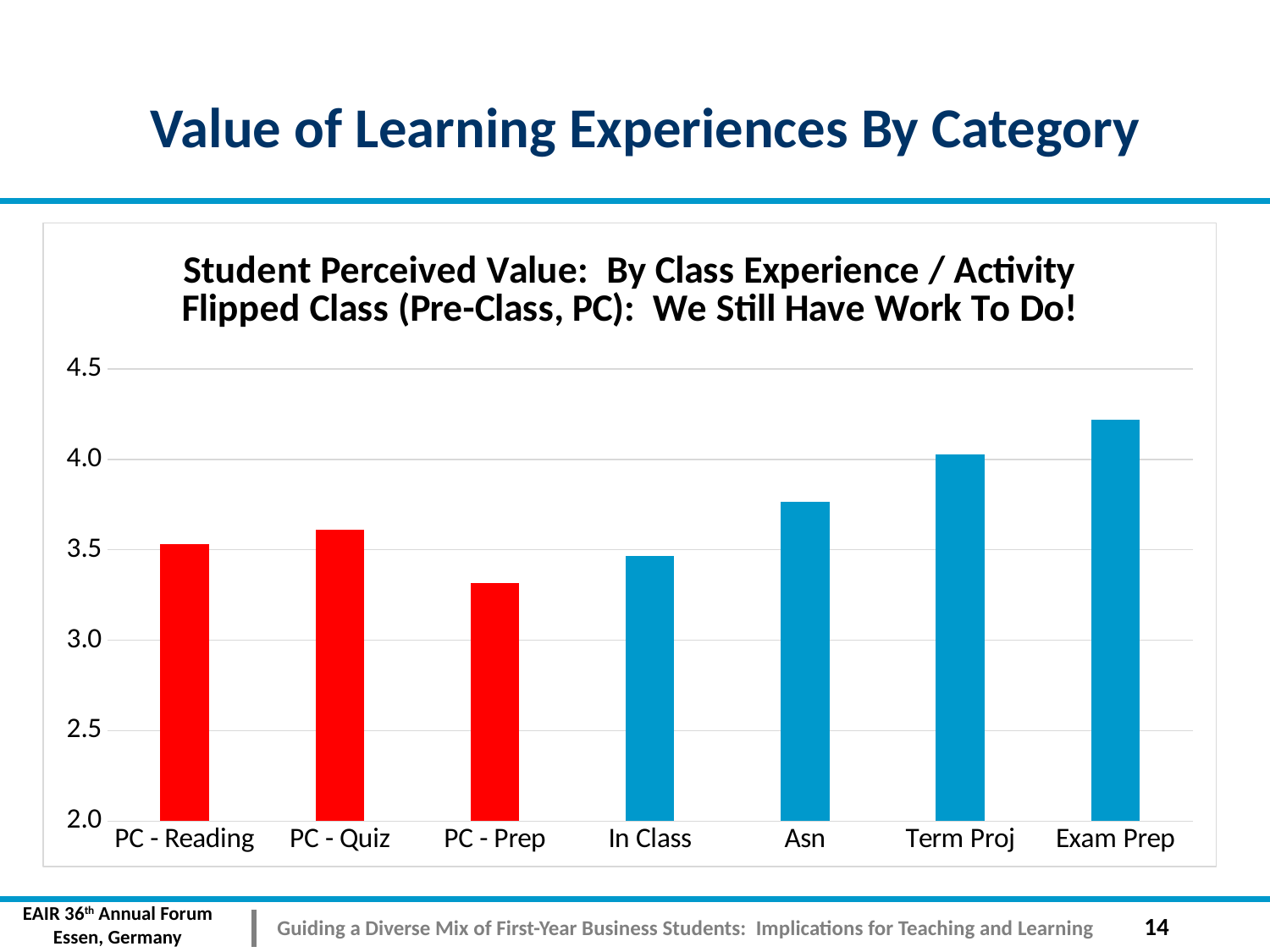
Which has a higher value, Asn or In Class? Asn Is the value for Exam Prep greater or less than 4.0? greater Which has a higher value, PC - Quiz or PC - Prep? PC - Quiz Which category has the highest student perceived value? Exam Prep Which categories are shown with red bars? PC - Reading, PC - Quiz, PC - Prep Is the value for PC - Prep greater or less than 3.5? less Which category has the lowest student perceived value? PC - Prep What kind of chart is shown on the slide? bar chart How many categories are shown on the x axis of the chart? 7 Is the value for Asn greater or less than 3.5? greater How many bars in the chart are coloured red? 3